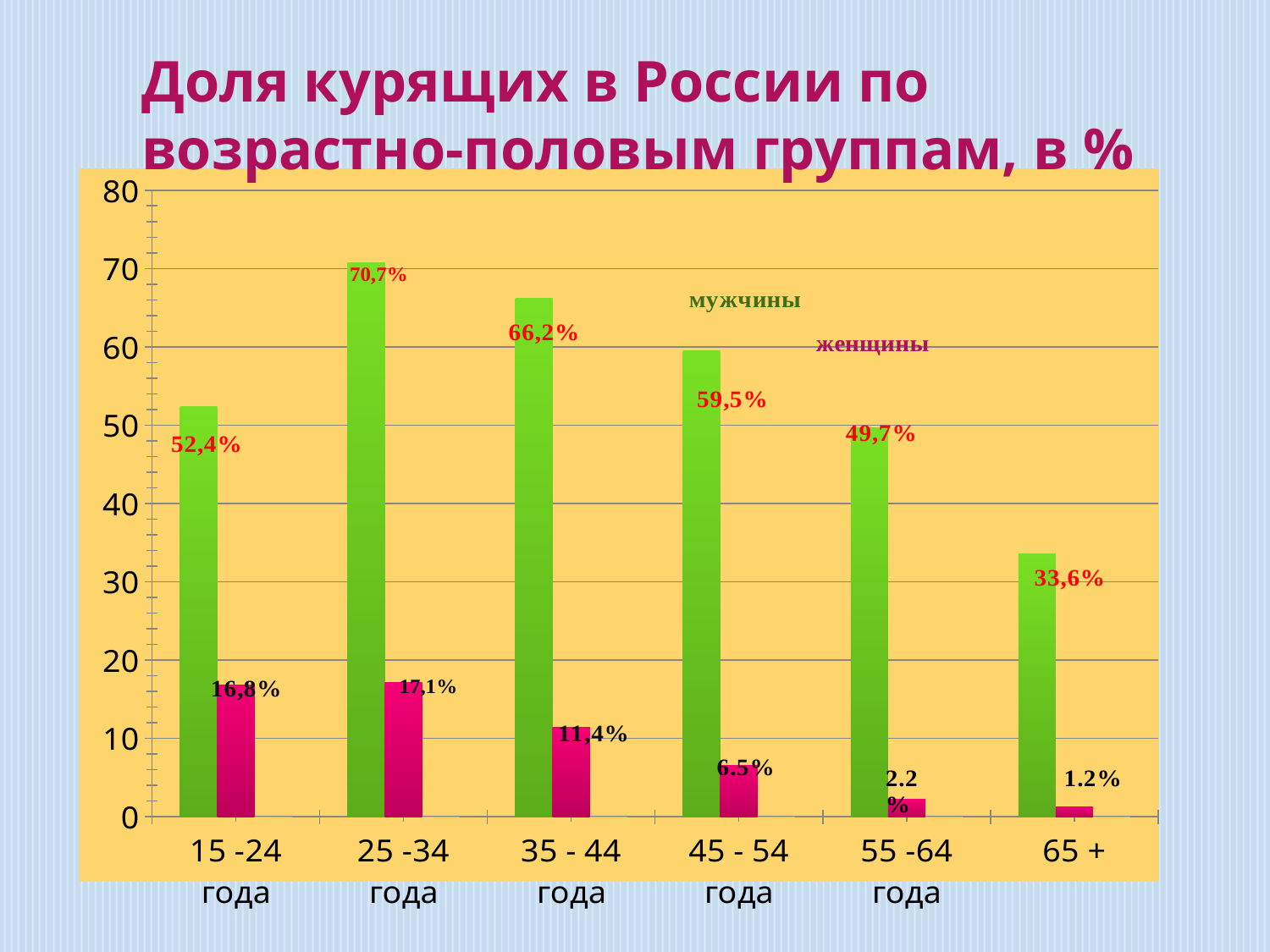
Do the values for men (мужчины) rise or fall from the 25-34 года group to the 65+ group? fall Which age group has the highest share of smoking men (мужчины)? 25-34 года Which age group has the lowest share of smoking women (женщины)? 65+ What is the share of smokers among men (мужчины) aged 65+? 33,6% What type of chart is shown on the slide? bar chart What is the share of smokers among women (женщины) aged 35-44 года? 11,4% What is the share of smokers among women (женщины) aged 45-54 года? 6.5% How many data series does the chart show? 2 What is the share of smokers among men (мужчины) aged 25-34 года? 70,7% Which is larger: the share of smoking women aged 15-24 года or aged 25-34 года? 25-34 года What is the difference between the share of smoking men and smoking women in the 15-24 года group? 35,6% How many age groups are shown on the x axis? 6